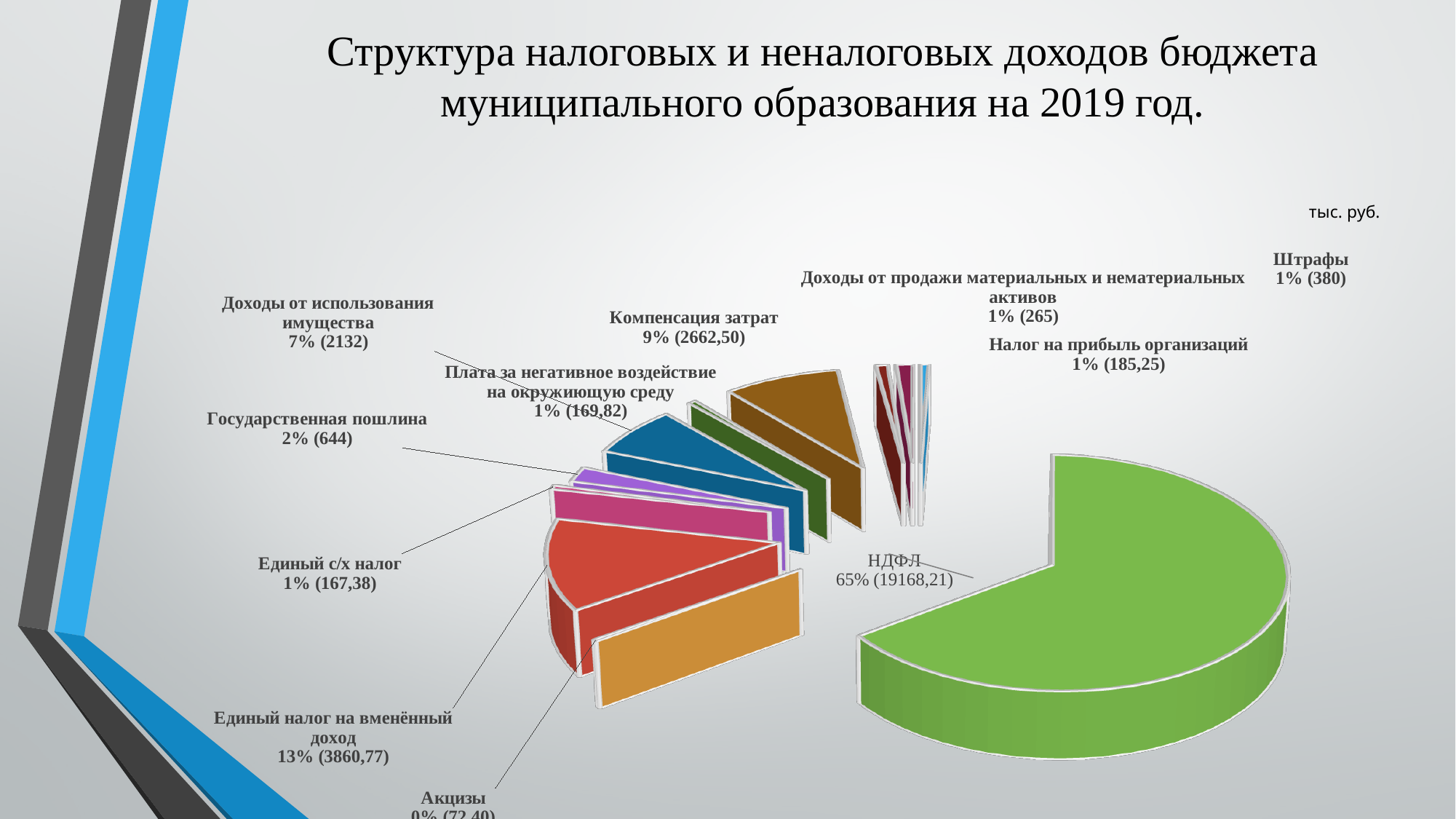
How many categories are shown in the pie chart? 11 What share of the budget revenue does НДФЛ account for? 65% What is the value shown for Государственная пошлина? 2% (644) What is the difference in thousand rubles between Государственная пошлина (644) and Штрафы (380)? 264 What is the value shown for Компенсация затрат? 9% (2662,50) What is the value shown for Налог на прибыль организаций? 1% (185,25) What kind of chart is shown on the slide? pie chart Which is larger: Компенсация затрат or Доходы от использования имущества? Компенсация затрат What is the value shown for Единый налог на вменённый доход? 13% (3860,77) Which category has the largest share of the pie? НДФЛ Which category has the smallest share of the pie? Акцизы In what units are the values in the chart given, according to the note on the slide? тыс. руб.